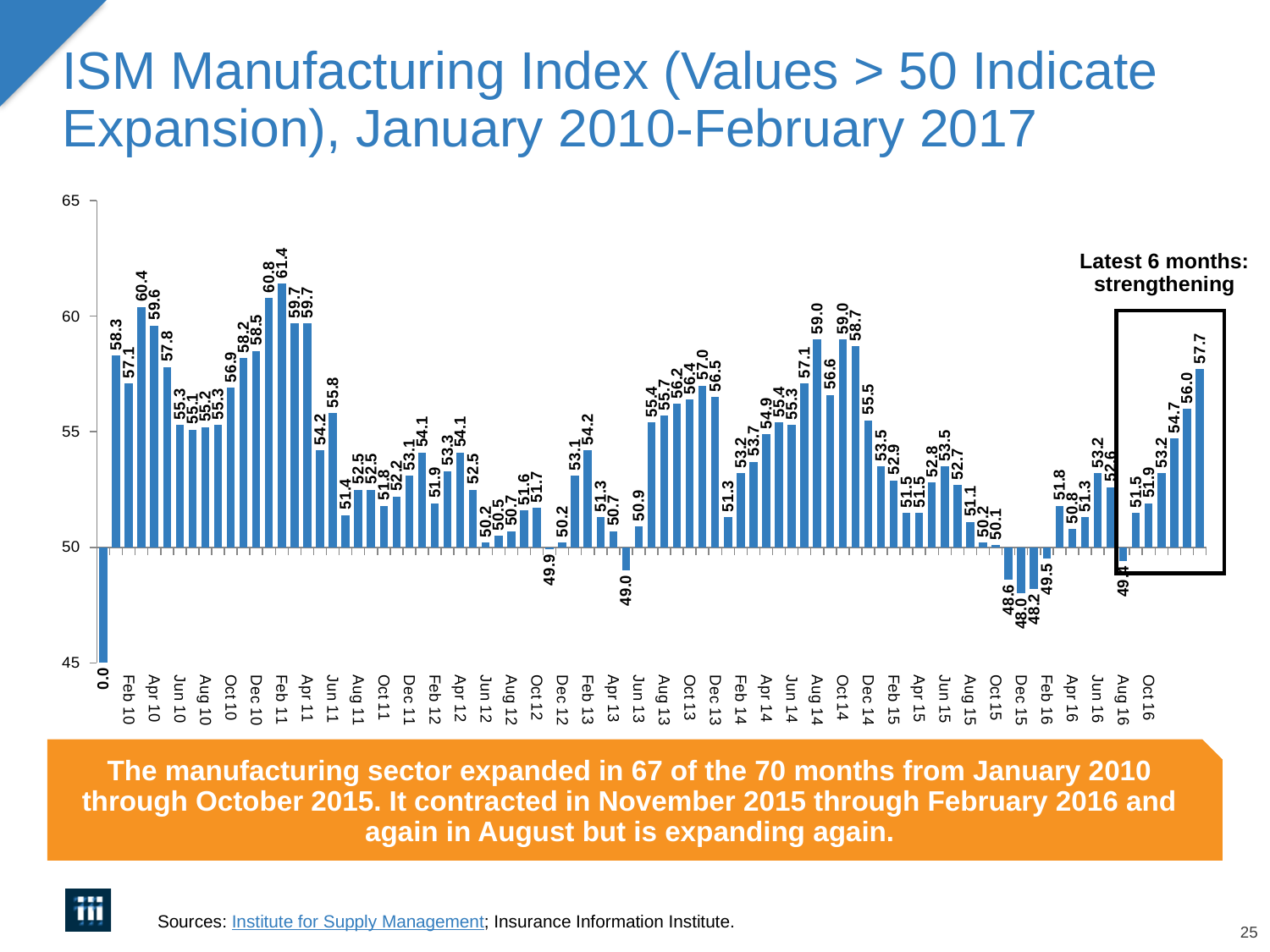
What is the lowest value among the bars for November 2015 through February 2016? 48.0 What is the highest value of the ISM Manufacturing Index shown on the chart? 61.4 What type of chart is used to show the ISM Manufacturing Index? bar chart What does the annotation above the boxed bars at the right of the chart say? Latest 6 months: strengthening How many bars fall below 50 in the period from November 2015 through February 2016? 4 According to the chart title, values above what number indicate expansion? 50 What is the difference between the highest value on the chart (61.4) and the latest value (57.7)? 3.7 Is the value for Oct 14 greater or less than 55? greater What is the value of the last bar on the chart (February 2017)? 57.7 What is the value of the bar for August 2016, the month the caption says the sector contracted? 49.4 Do the values in the 'Latest 6 months' box rise or fall from left to right? rise What is the difference between the highest value (61.4) and the lowest value in the Nov 2015-Feb 2016 contraction (48.0)? 13.4